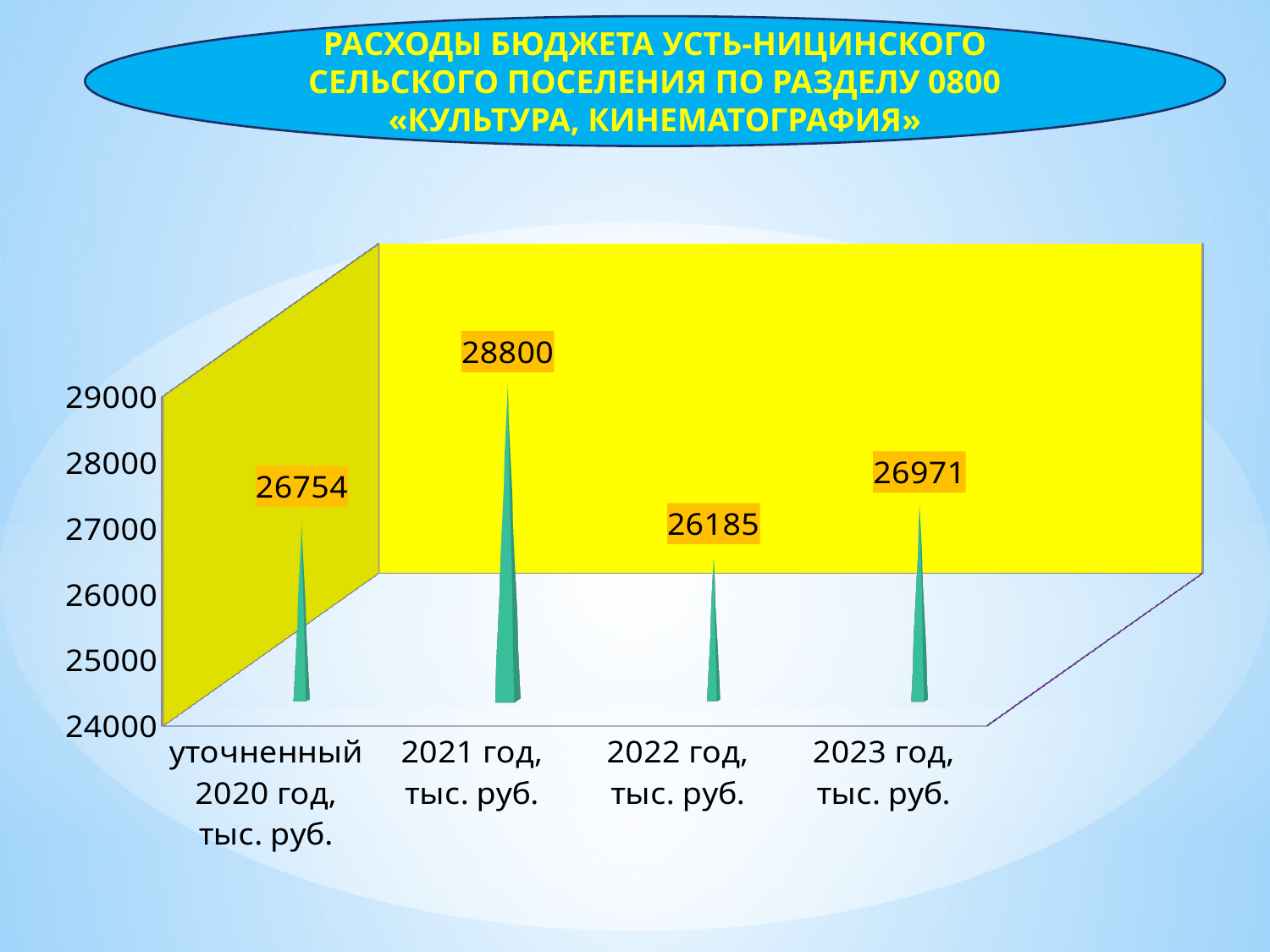
Which category has the lowest value? 2022 год, тыс. руб. What is the value for уточненный 2020 год, тыс. руб.? 26754 What is the difference between the values for 2021 год and 2022 год? 2615 What kind of chart is shown on the slide? bar chart How many categories are shown on the x axis? 4 What is the value for 2022 год, тыс. руб.? 26185 What is the value for 2023 год, тыс. руб.? 26971 Which category has the highest value? 2021 год, тыс. руб. Which is larger, the value for 2023 год or the value for 2022 год? 2023 год, тыс. руб. What is the difference between the values for 2023 год and уточненный 2020 год? 217 What is the value for 2021 год, тыс. руб.? 28800 Does the value rise or fall from 2021 год to 2022 год? fall